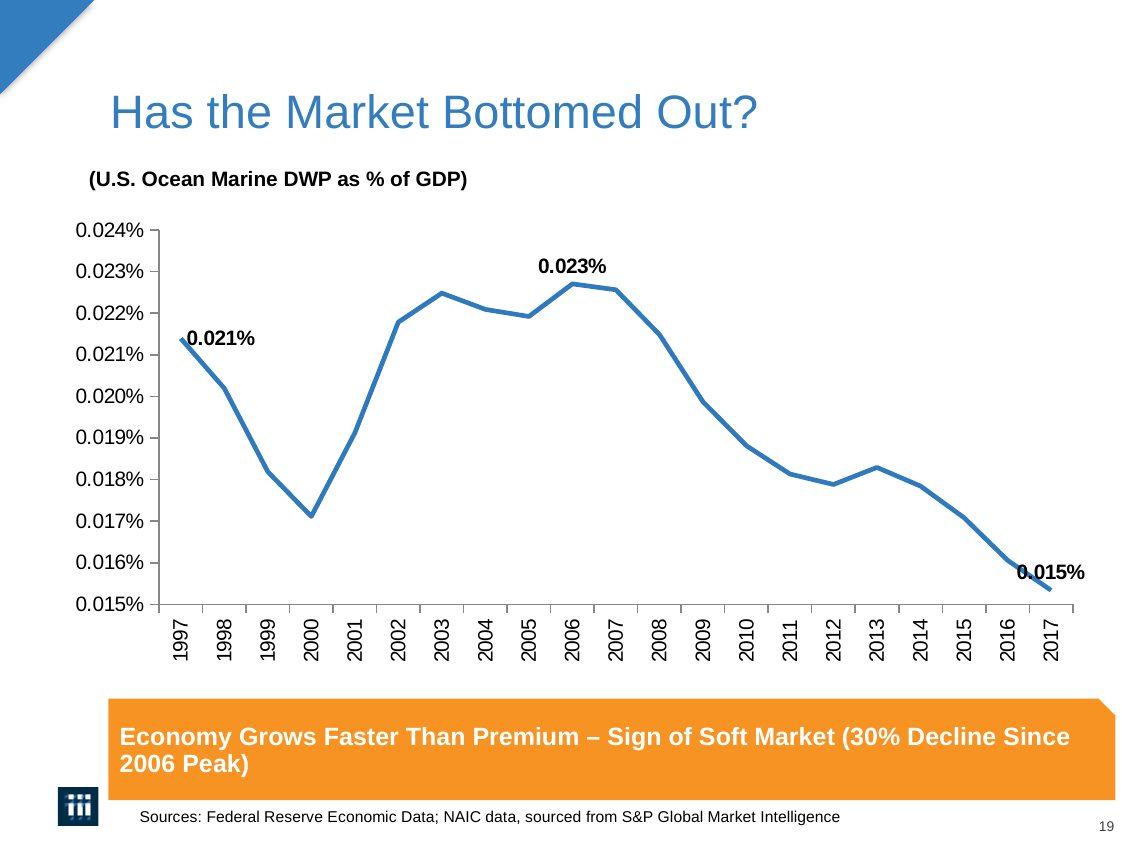
Which year has the highest value? 2006 What is the value for 2006? 0.023% What is the value for 2017? 0.015% What is the value for 1997? 0.021% Which is larger, the value for 1997 or the value for 2017? 1997 What is the difference between the 2006 value and the 2017 value? 0.008% How many years are plotted on the x axis? 21 Is the value for 2000 greater or less than 0.018%? less Which year has the lowest value? 2017 What kind of chart is shown? line chart Is the value for 2002 greater or less than 0.021%? greater Do the values rise or fall from 2006 to 2017? fall